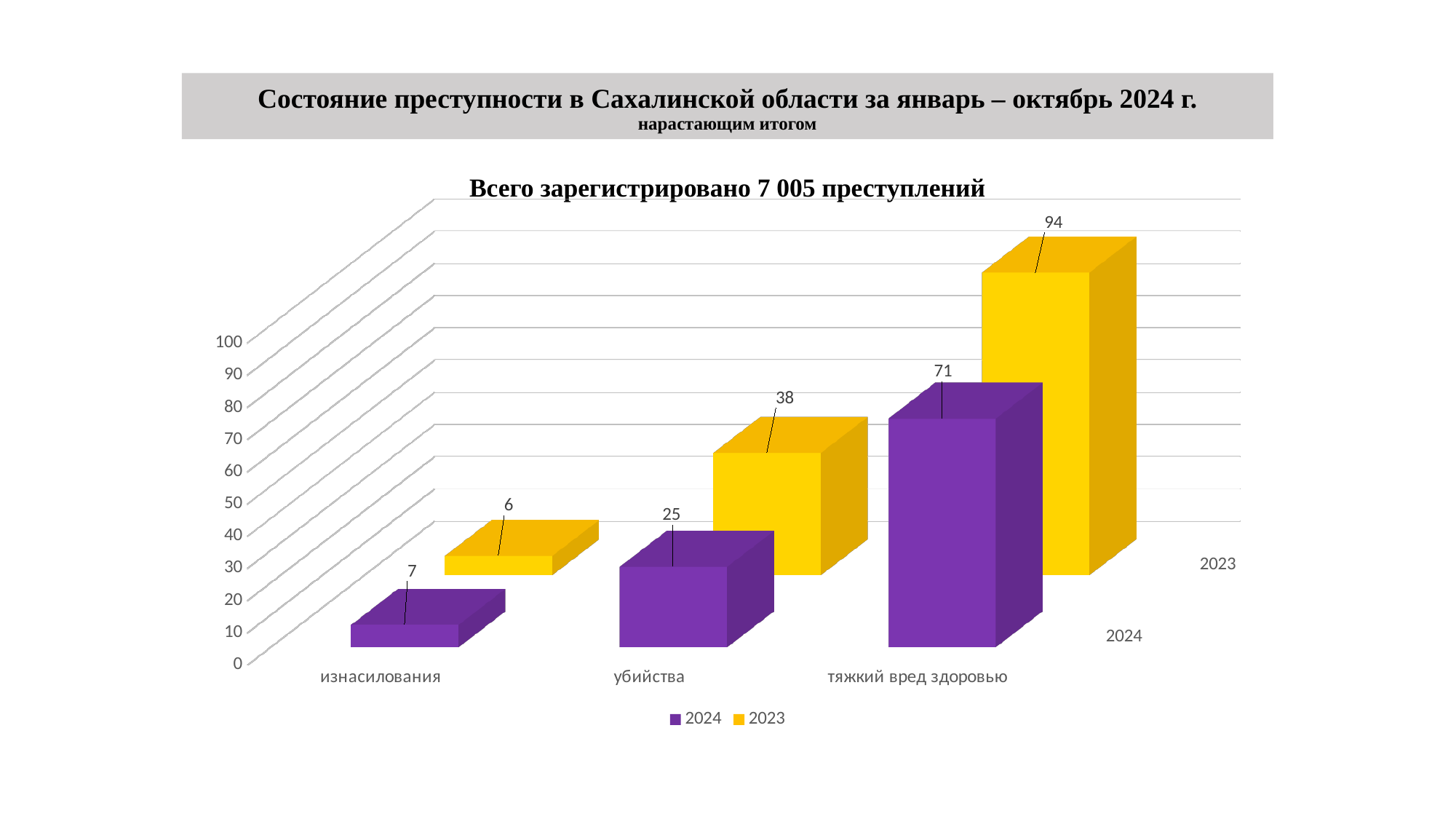
How many series does the legend list? 2 Which is larger for изнасилования: the 2024 value or the 2023 value? 2024 Which category has the highest value in the 2024 series? тяжкий вред здоровью What is the difference between the 2023 and 2024 values for убийства? 13 What kind of chart is shown on the slide? bar chart How many categories are shown on the x axis? 3 What is the value for убийства in the 2024 series? 25 Which category has the lowest value in the 2023 series? изнасилования What is the value for тяжкий вред здоровью in the 2023 series? 94 What is the value for изнасилования in the 2023 series? 6 What is the title of the chart? Всего зарегистрировано 7 005 преступлений What is the difference between the 2023 and 2024 values for тяжкий вред здоровью? 23